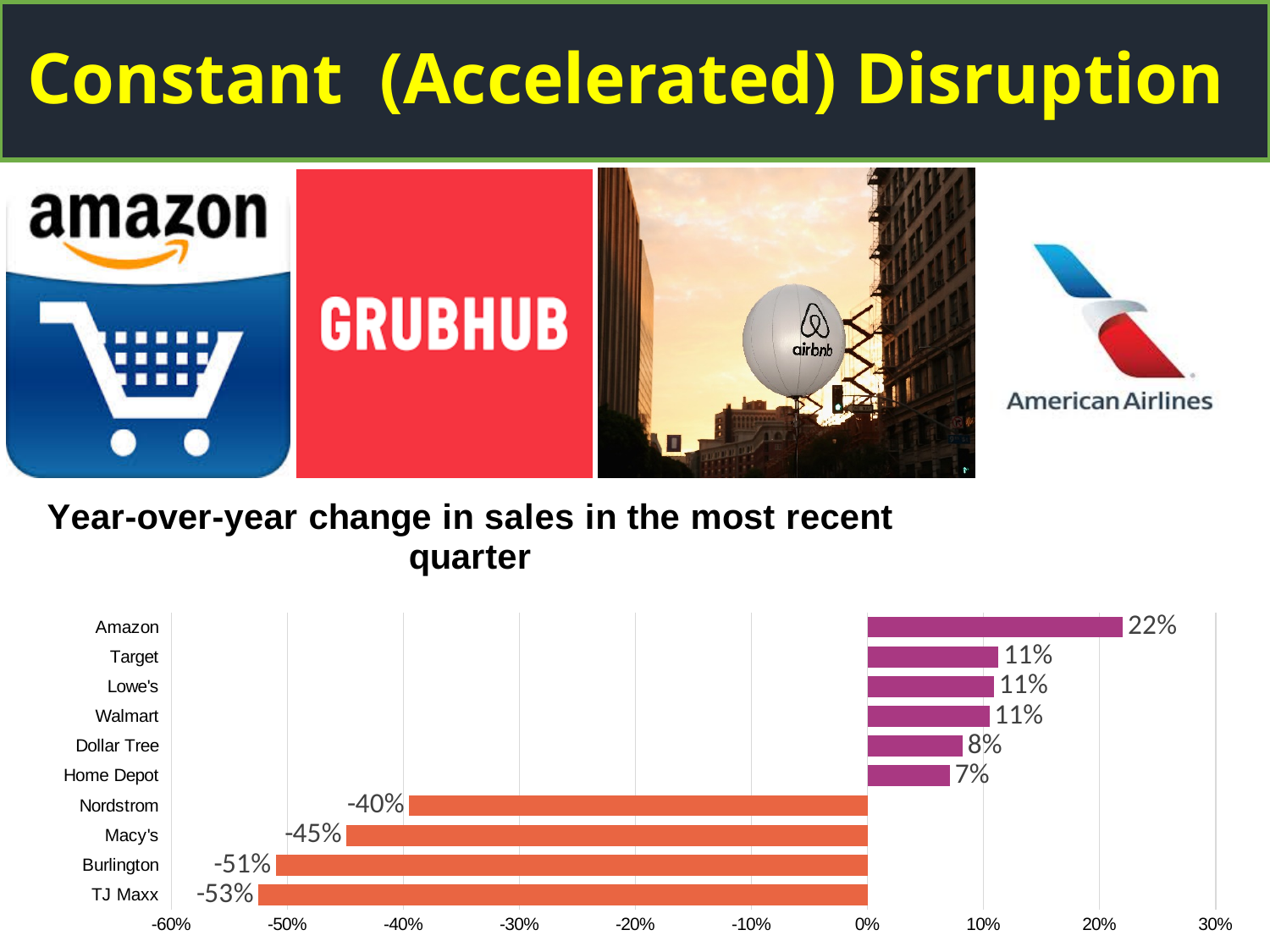
What is the year-over-year change in sales for Macy's? -45% Which company has the highest year-over-year change in sales? Amazon How many companies are shown in the chart? 10 Which has a larger year-over-year change in sales, Dollar Tree or Home Depot? Dollar Tree What kind of chart is shown on the slide? Bar chart What is the year-over-year change in sales for Amazon? 22% What is the title of the chart? Year-over-year change in sales in the most recent quarter Which company has the lowest year-over-year change in sales? TJ Maxx Is the value for Nordstrom greater or less than -30%? less What is the difference between Amazon's and Target's year-over-year change in sales? 11 percentage points What is the year-over-year change in sales for Home Depot? 7% What is the year-over-year change in sales for TJ Maxx? -53%